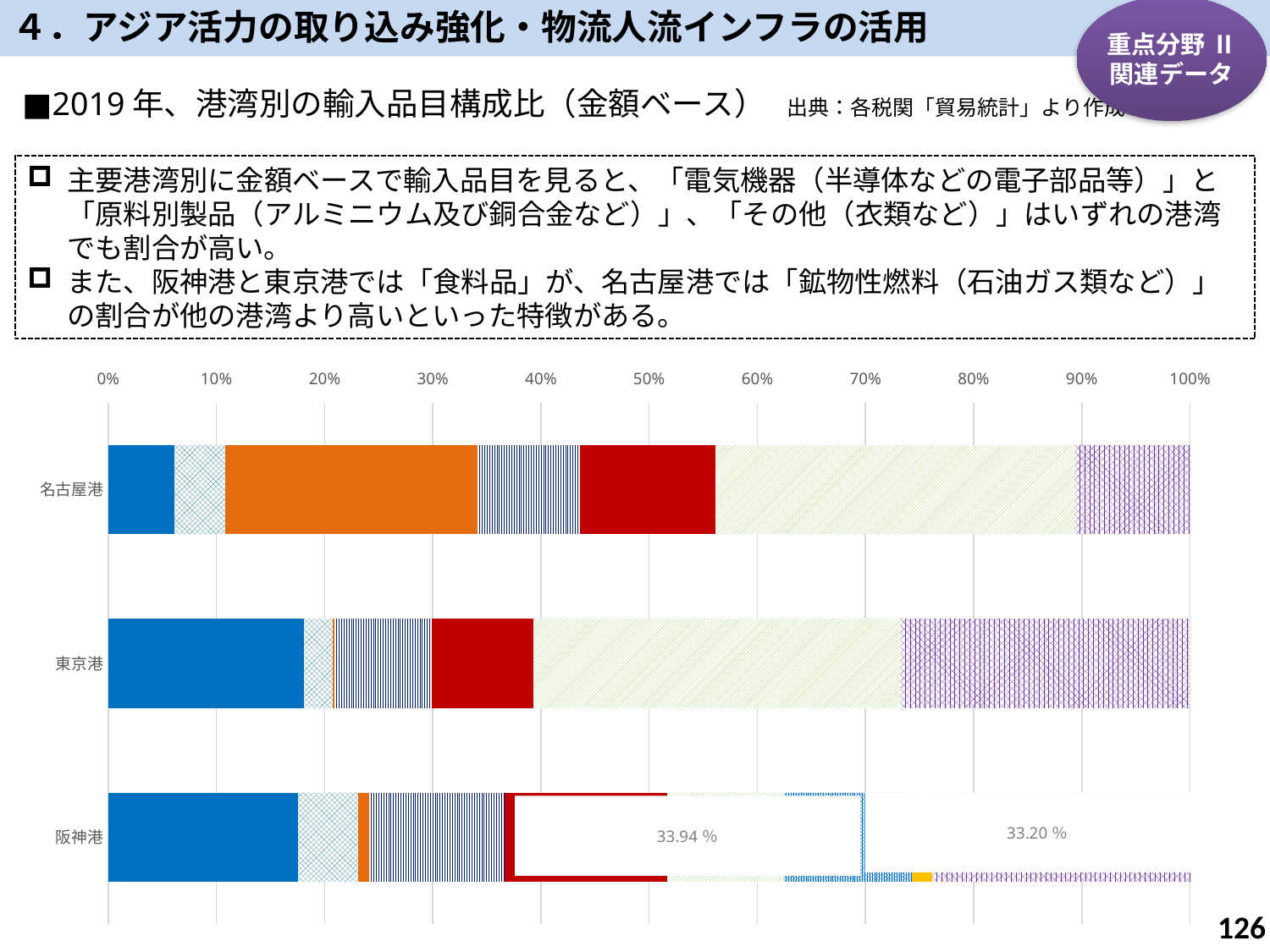
What kind of chart is shown on the slide? Stacked bar chart Which port has the larger solid blue (first) segment, 名古屋港 or 東京港? 東京港 Is the solid red segment of the 名古屋港 bar greater or less than 10%? greater Is the first (solid blue) segment of the 東京港 bar greater or less than 10%? greater Which port has the larger solid red segment, 名古屋港 or 阪神港? 阪神港 How many ports (categories) are plotted in the chart? 3 Which port has the larger solid orange segment, 名古屋港 or 東京港? 名古屋港 Is the first (solid blue) segment of the 名古屋港 bar greater or less than 10%? less What is the maximum value shown on the horizontal axis of the chart? 100%